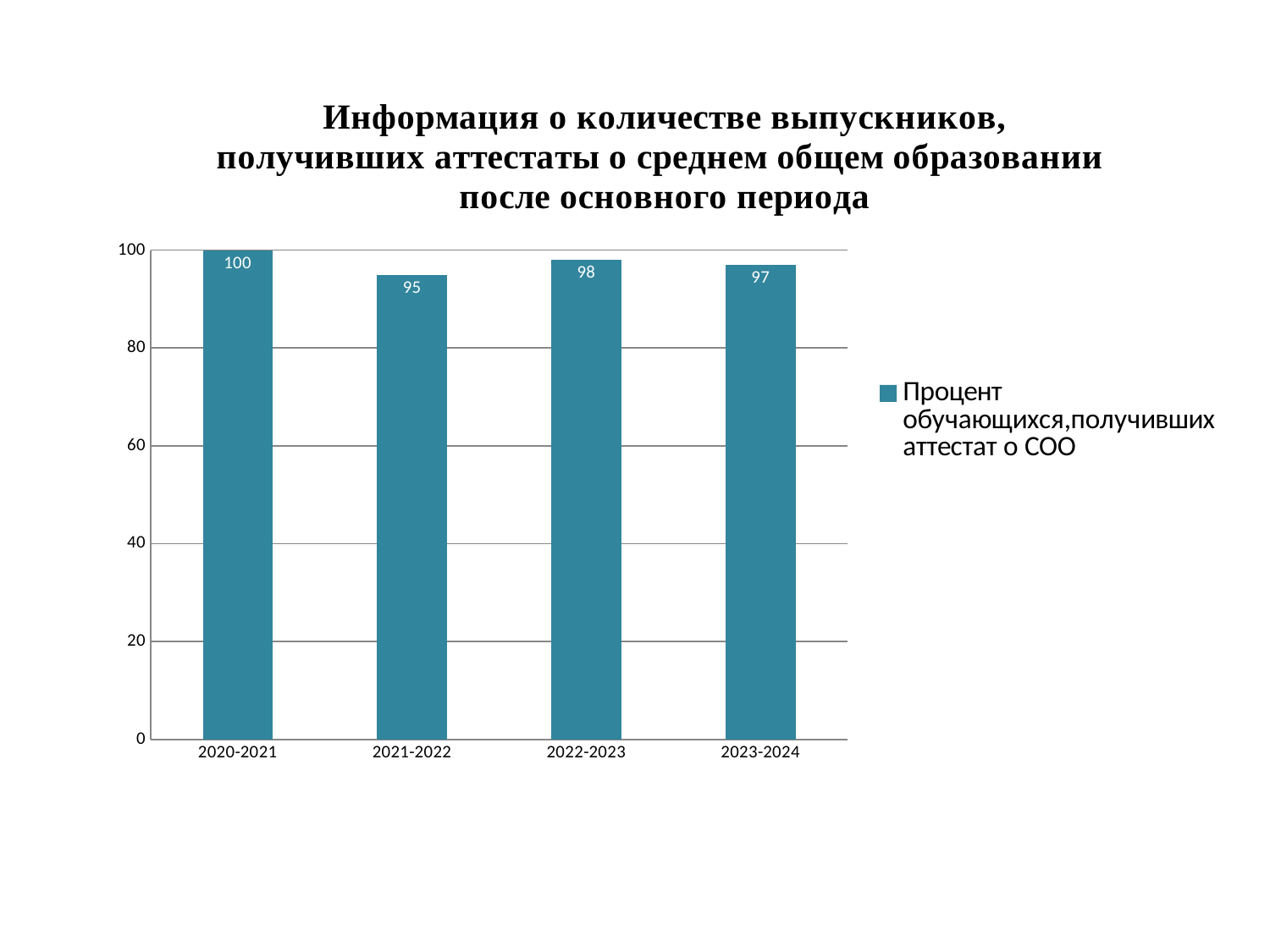
Which is larger, the value for 2022-2023 or the value for 2023-2024? 2022-2023 What is the value for 2022-2023? 98 Which year has the lowest value? 2021-2022 How many categories are shown on the x axis? 4 What is the difference between the values for 2020-2021 and 2021-2022? 5 Which year has the highest value? 2020-2021 How many series does the legend list? 1 What kind of chart is shown on the slide? bar chart What is the value for 2021-2022? 95 What is the legend entry for the series? Процент обучающихся,получивших аттестат о СОО What is the value for 2023-2024? 97 What is the value for 2020-2021? 100